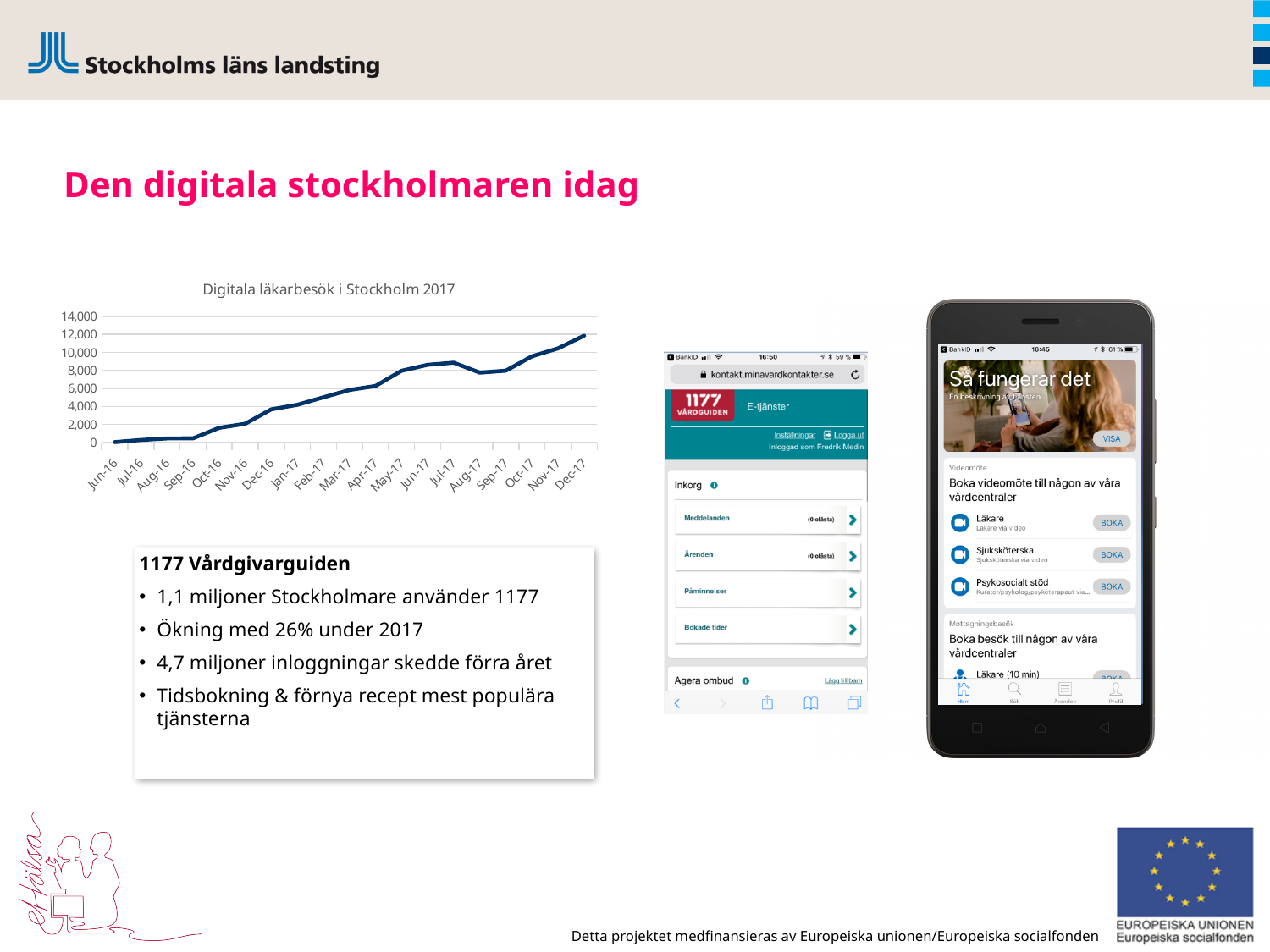
Is the value for Mar-17 greater or less than 4,000? greater Which is larger, the value for Dec-17 or the value for Jan-17? Dec-17 Is the value for Aug-17 greater or less than 6,000? greater Is the value for Dec-17 greater or less than 10,000? greater How many months are plotted along the x axis of the chart? 19 Do the values in the chart generally rise or fall from Jun-16 to Dec-17? rise Which month has the highest value in the chart? Dec-17 Which month has the lowest value in the chart? Jun-16 What kind of chart is shown on the slide? line chart What is the title of the chart on the slide? Digitala läkarbesök i Stockholm 2017